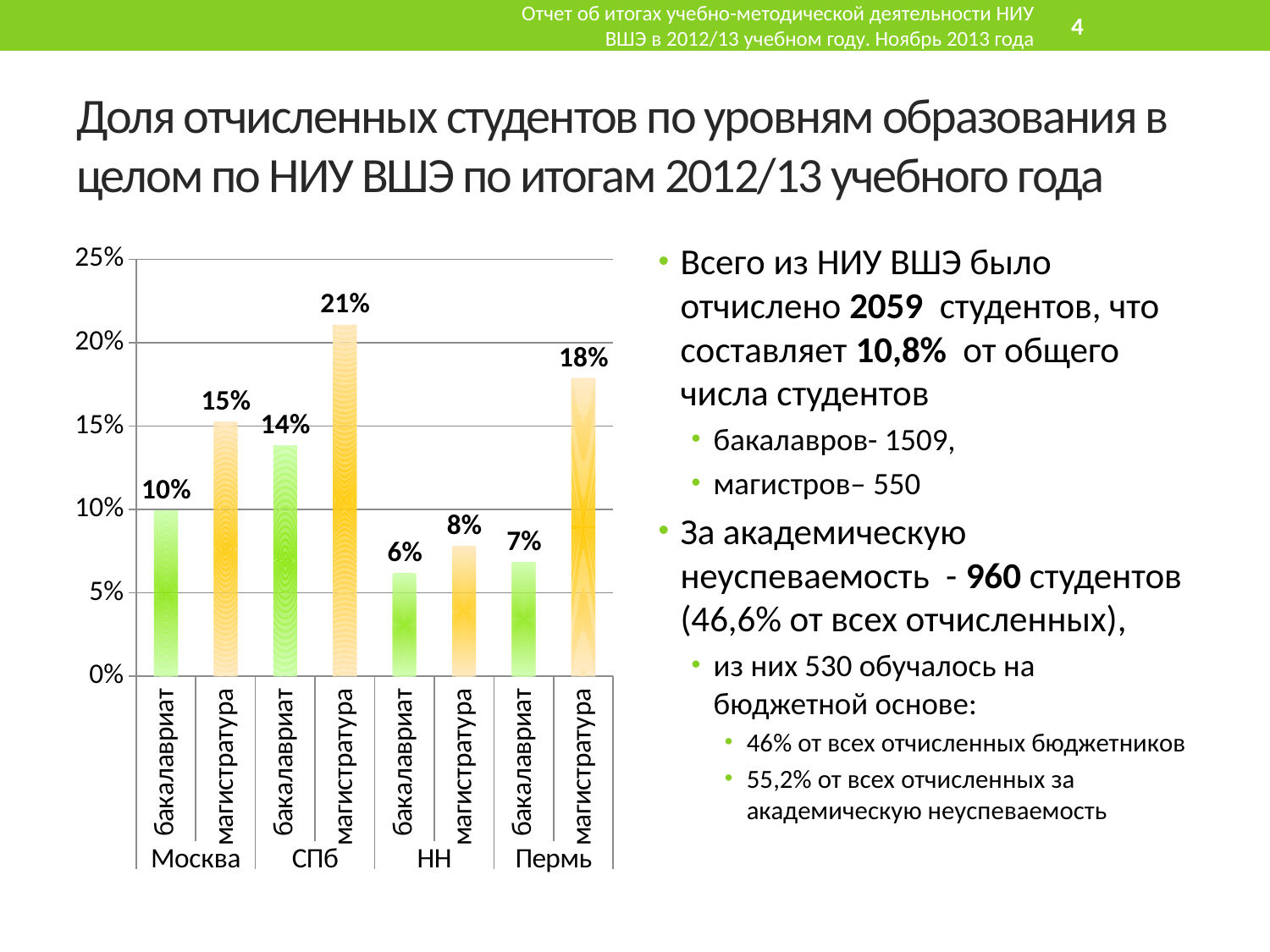
What is the value for бакалавриат in Москва? 10% Which is larger: бакалавриат in СПб or магистратура in Москва? магистратура in Москва Is the value for магистратура in НН greater or less than 10%? less What is the value for магистратура in СПб? 21% Which bar has the highest value? магистратура, СПб How many bars are plotted in the chart? 8 What is the value for магистратура in Пермь? 18% What kind of chart is shown on the slide? bar chart How many cities are shown on the x axis of the chart? 4 What is the value for бакалавриат in НН? 6% Which bar has the lowest value? бакалавриат, НН What is the difference between магистратура and бакалавриат in Пермь? 11%